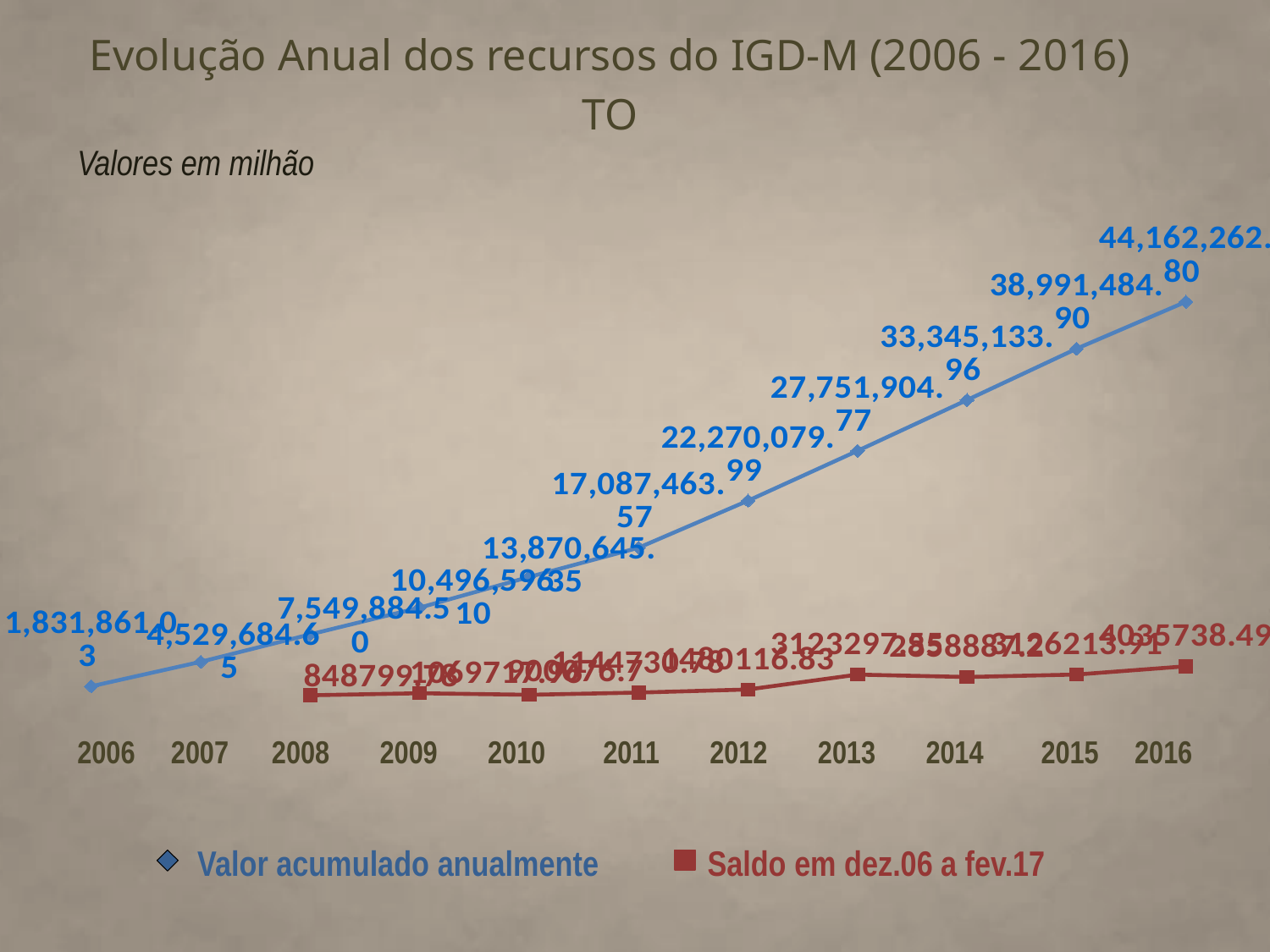
In which year is 'Valor acumulado anualmente' lowest? 2006 What is the value of 'Valor acumulado anualmente' in 2006? 1,831,861.03 What unit note is shown under the chart title? Valores em milhão Does 'Valor acumulado anualmente' rise or fall from 2006 to 2016? Rise How many years are shown on the x axis? 11 How many series does the legend list? 2 What is the value of 'Valor acumulado anualmente' in 2013? 27,751,904.77 What kind of chart is shown on the slide? Line chart In 2016, which series has the larger value: 'Valor acumulado anualmente' or 'Saldo em dez.06 a fev.17'? Valor acumulado anualmente In which year is 'Valor acumulado anualmente' highest? 2016 What is the value of 'Valor acumulado anualmente' in 2015? 38,991,484.90 What is the difference between 'Valor acumulado anualmente' in 2015 and in 2014? 5,646,350.94